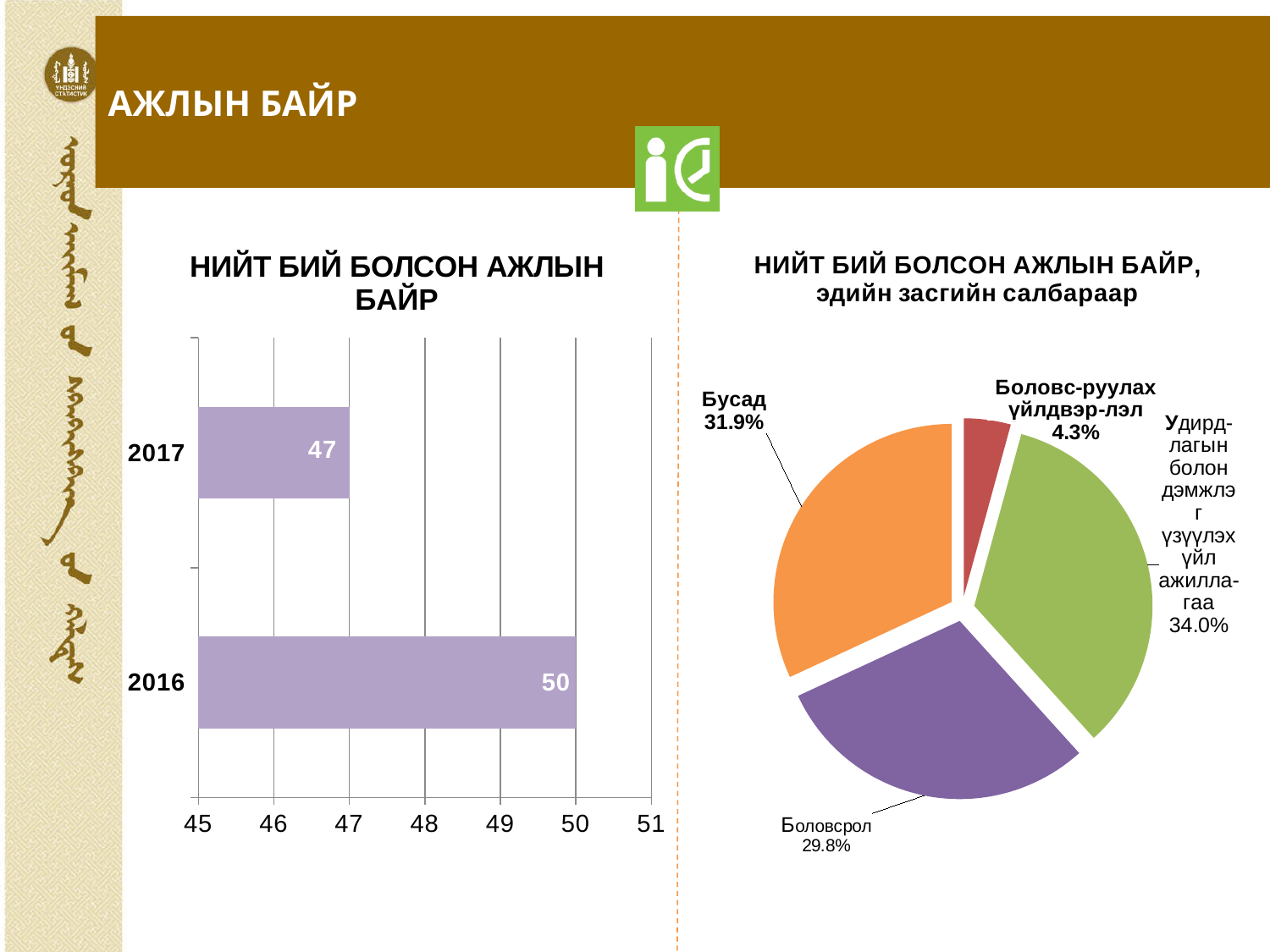
In the bar chart on the left, what is the value for 2017? 47 In the pie chart on the right, what share does Боловсрол have? 29.8% In the pie chart on the right, what share does Бусад have? 31.9% In the bar chart on the left, how many years are shown? 2 In the bar chart on the left, which year has the higher value, 2016 or 2017? 2016 In the pie chart on the right, how many slices are there? 4 In the bar chart on the left, what is the value for 2016? 50 In the pie chart on the right, what share does Боловсруулах үйлдвэрлэл have? 4.3% In the pie chart on the right, which slice is the largest? Удирдлагын болон дэмжлэг үзүүлэх үйл ажиллагаа (34.0%) In the bar chart on the left, what is the difference between the values for 2016 and 2017? 3 In the pie chart on the right, which slice is the smallest? Боловсруулах үйлдвэрлэл (4.3%) What kind of chart is the one on the left of the slide? Bar chart